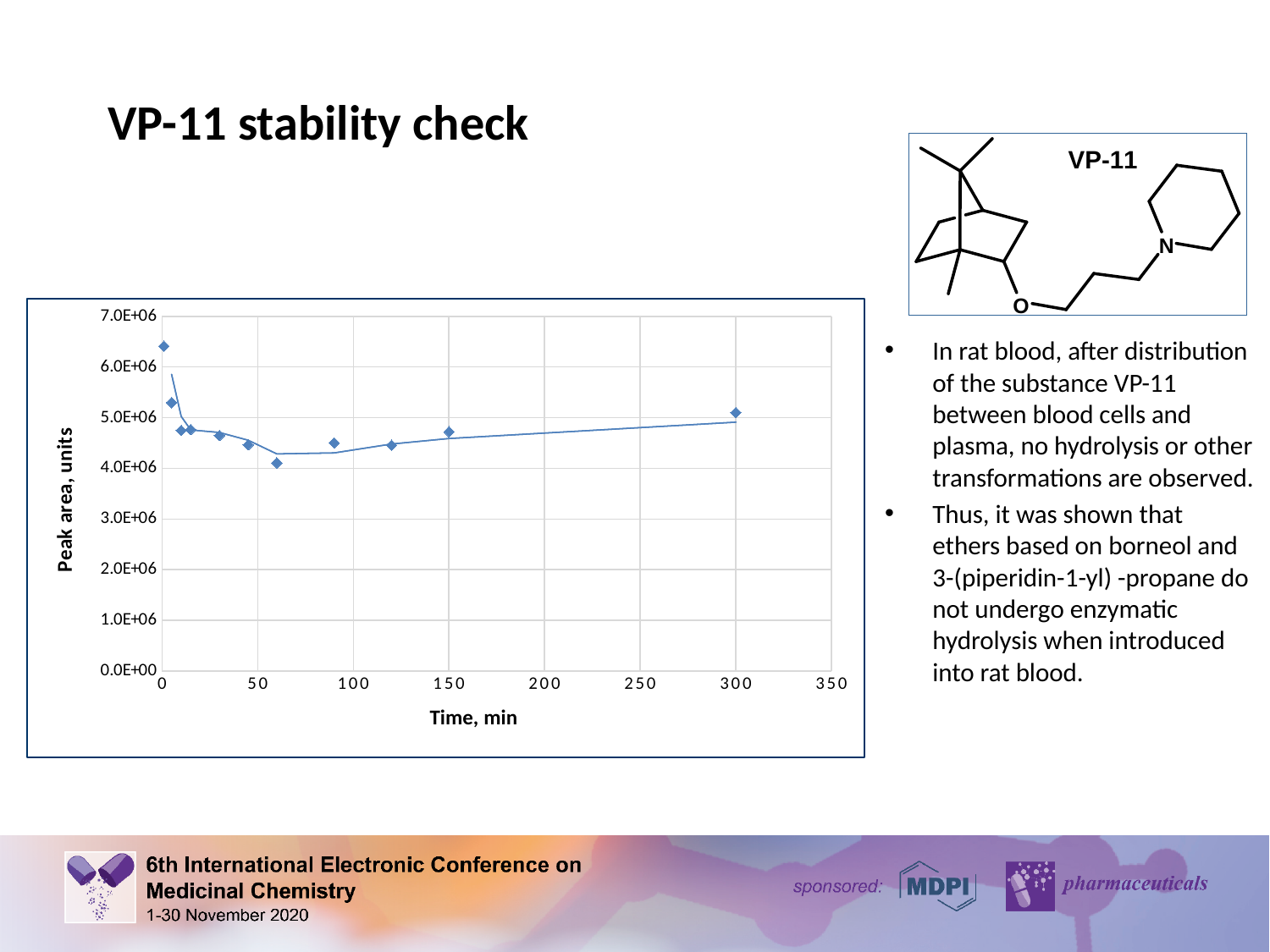
What is the title of the x axis of the chart? Time, min How many data points are plotted on the chart? 11 Which has the larger peak area: the point at 300 min or the point at 60 min? 300 min At which time point is the peak area lowest? 60 min What kind of chart is shown on the slide? scatter plot with a smoothed line At which time point is the peak area highest? the first point, near 0 min What is the title of the y axis of the chart? Peak area, units Is the peak area at 60 min greater or less than 5.0E+06? less Is the peak area of the first data point (near time 0) greater or less than 6.0E+06? greater Is the peak area at 150 min greater or less than 4.0E+06? greater